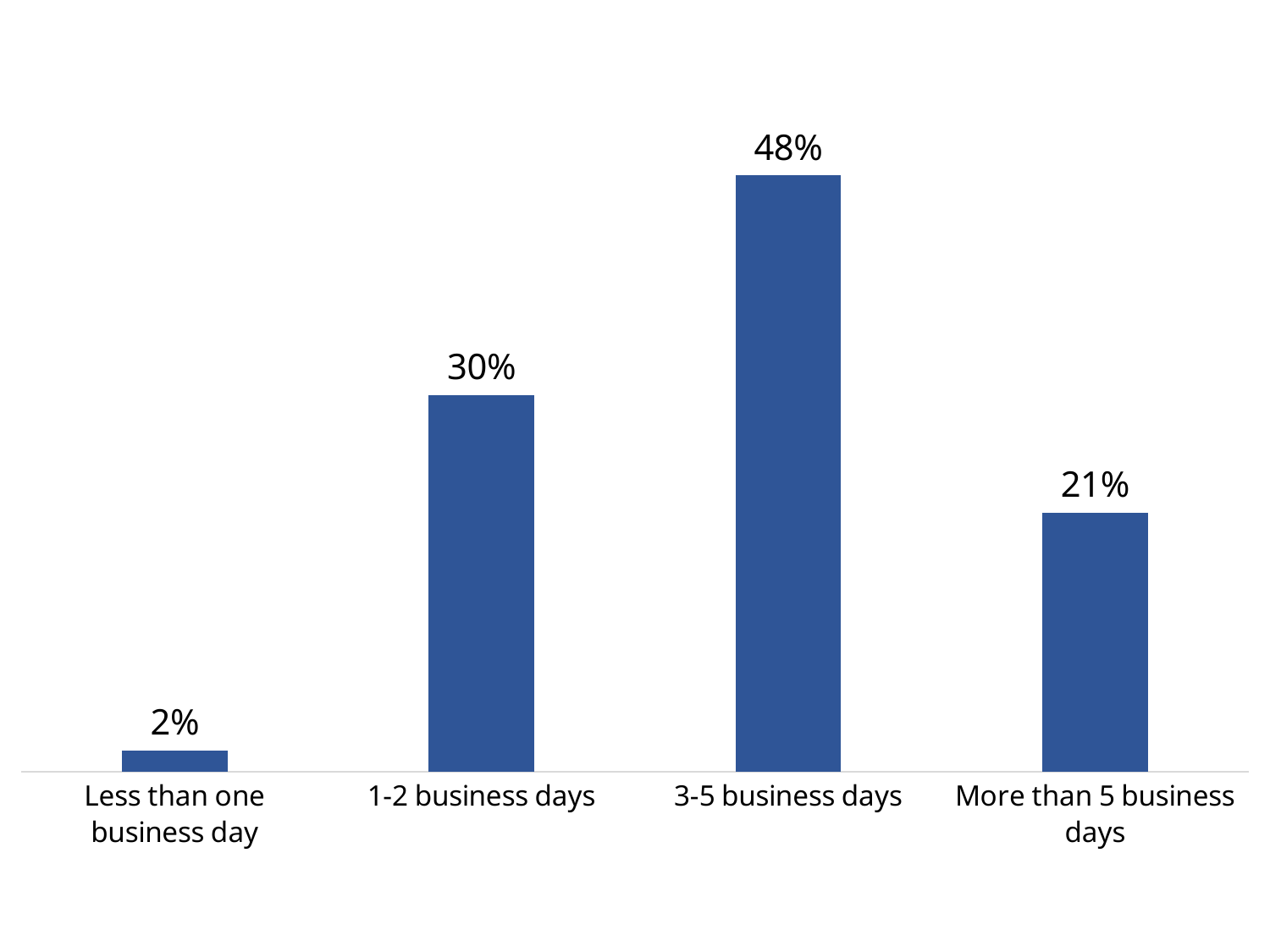
How many categories are shown in the chart? 4 What is the value for 1-2 business days? 30% Which is larger, the value for 1-2 business days or the value for More than 5 business days? 1-2 business days What colour are the bars in the chart? Blue Which category has the lowest value? Less than one business day What is the value for Less than one business day? 2% Which category has the highest value? 3-5 business days What is the difference between the values for 3-5 business days and 1-2 business days? 18% What is the difference between the values for 1-2 business days and More than 5 business days? 9% What is the value for More than 5 business days? 21% What kind of chart is this? Bar chart What is the value for 3-5 business days? 48%